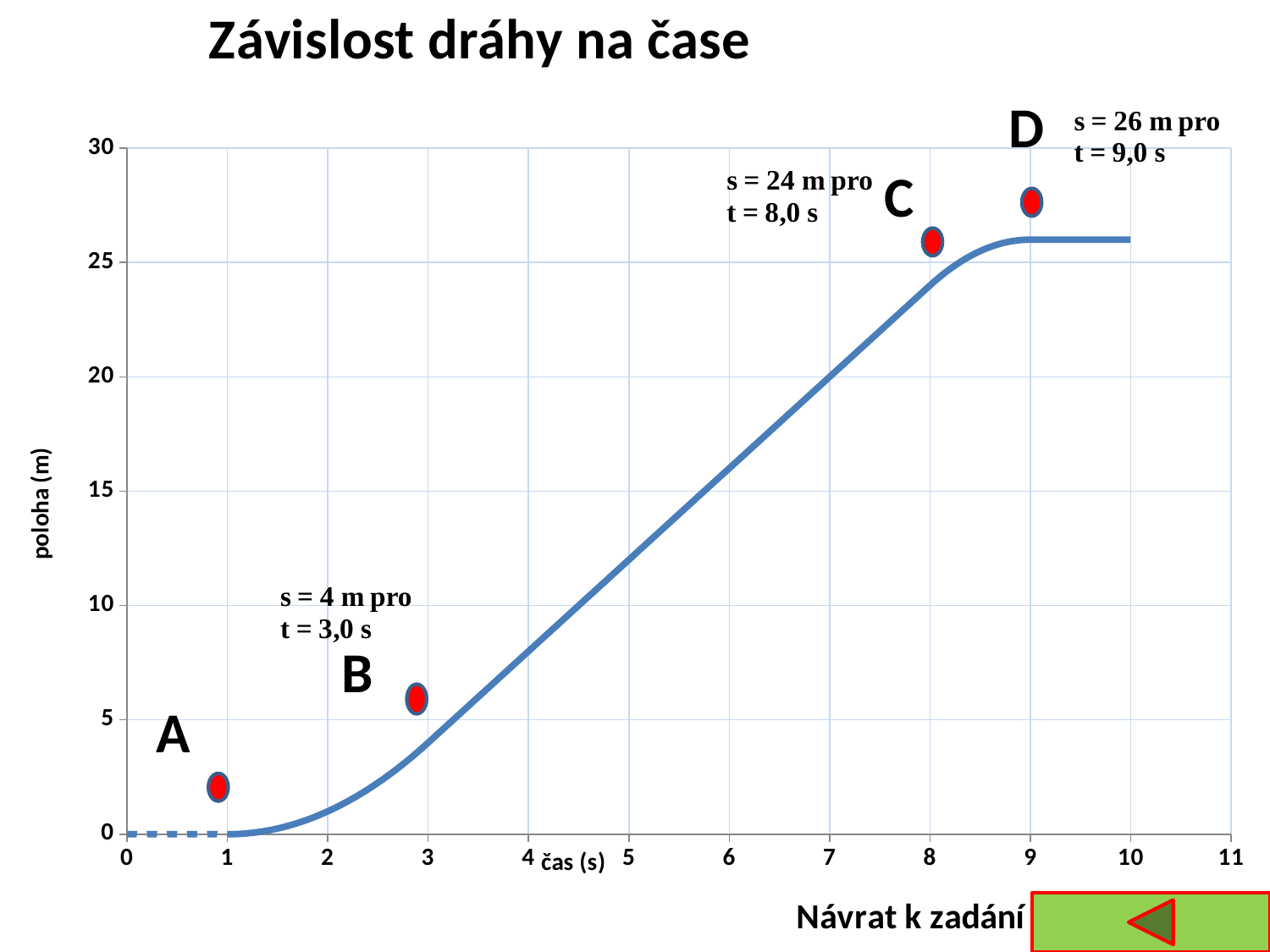
According to the annotation for point B, what is the value of s at t = 3,0 s? 4 m According to the annotation for point C, what is the value of s at t = 8,0 s? 24 m How many labelled points (A, B, C, D) are marked on the chart? 4 What kind of chart is shown on the slide? line chart Which of the annotated points, B, C or D, has the highest value of s? D Which annotated point has the larger s value, B or C? C What is the difference between the annotated s values for points D and C? 2 m Does the curve rise or fall between čas = 2 s and čas = 8 s? rise What is the title of the chart? Závislost dráhy na čase What is the label of the vertical axis? poloha (m) Is the value of the curve at čas = 6 s greater or less than 15? greater According to the annotation for point D, what is the value of s at t = 9,0 s? 26 m